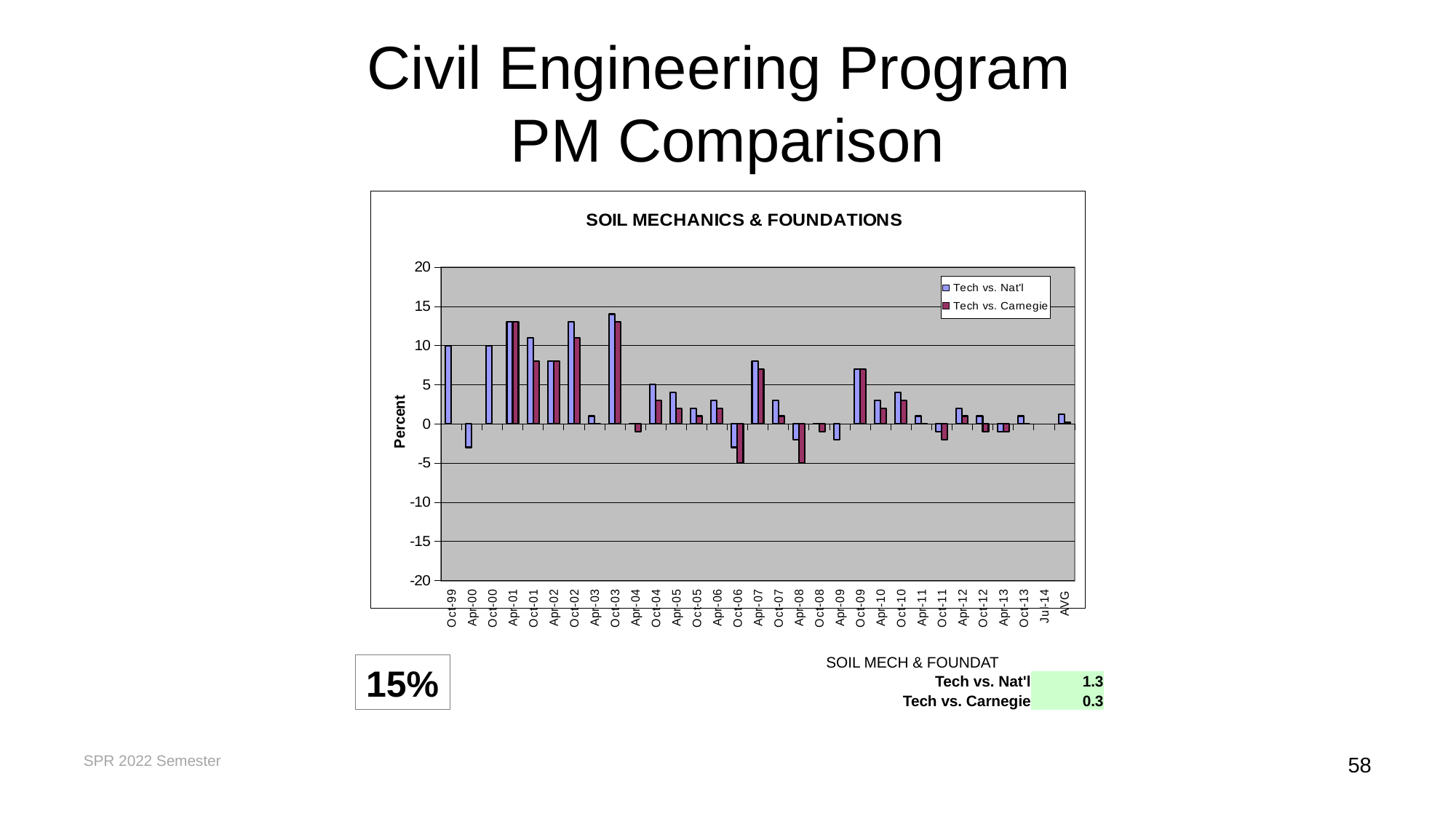
What are the two series named in the legend of the chart? Tech vs. Nat'l and Tech vs. Carnegie Do the Tech vs. Nat'l values generally rise or fall from Oct-99 to Jul-14? fall What kind of chart is shown on the slide? Bar chart How many series does the legend of the SOIL MECHANICS & FOUNDATIONS chart list? 2 How many categories are shown along the x axis of the chart, including AVG? 31 For Oct-01, which series has the larger value, Tech vs. Nat'l or Tech vs. Carnegie? Tech vs. Nat'l Is the Tech vs. Nat'l value for Oct-03 greater or less than 10? greater According to the table below the chart, what is the AVG value for Tech vs. Carnegie? 0.3 What is the label on the vertical axis of the chart? Percent According to the table below the chart, what is the AVG value for Tech vs. Nat'l? 1.3 Is the Tech vs. Nat'l value for Apr-00 greater or less than 0? less Is the Tech vs. Carnegie value for Oct-06 greater or less than 0? less